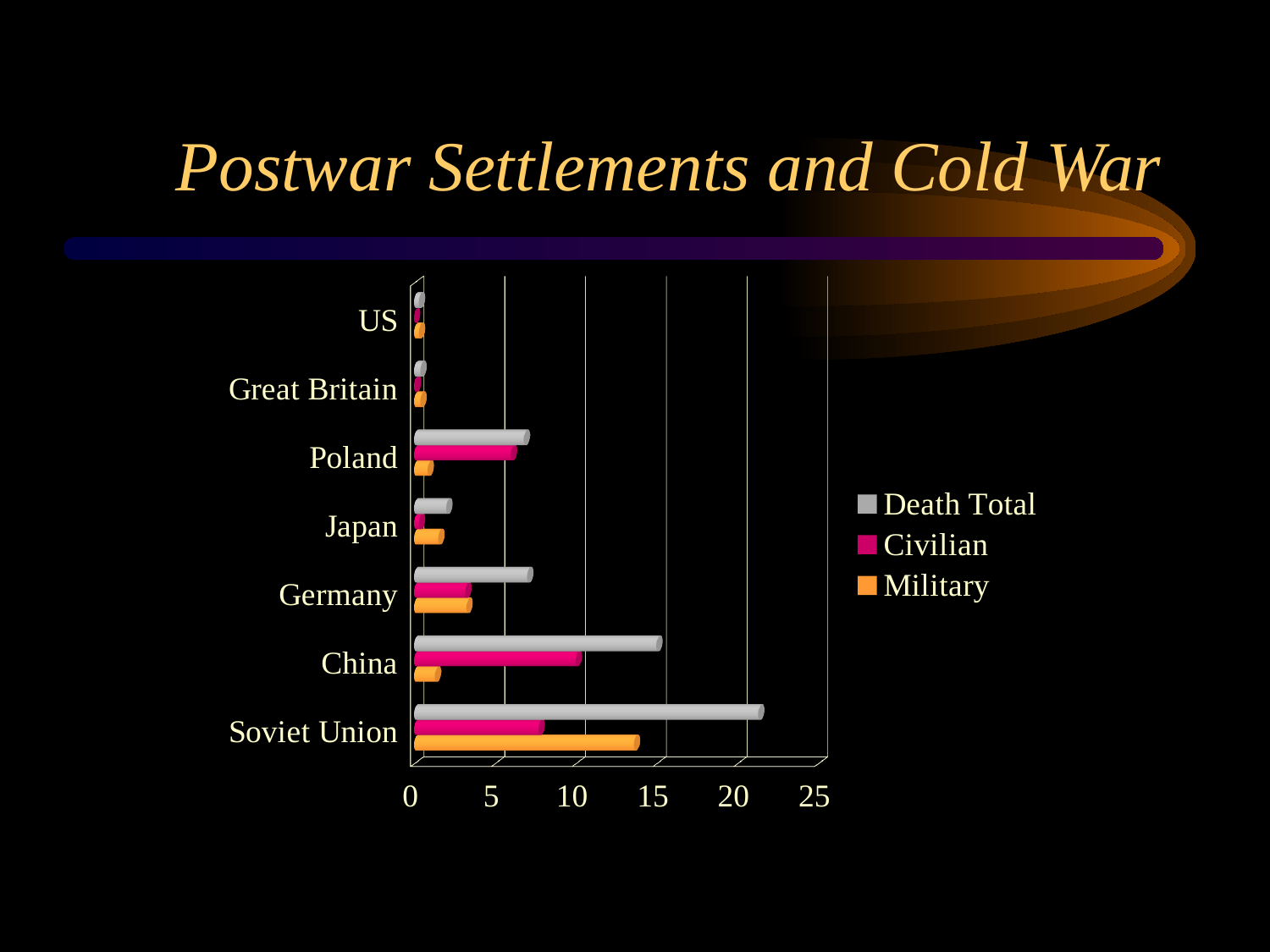
Which is larger for the Soviet Union, the Military bar or the Civilian bar? Military Which series is shown in orange in the legend? Military What kind of chart is shown on the slide? Bar chart Which country has the highest Death Total bar? Soviet Union How many series does the chart's legend list? 3 Is the Death Total value for the Soviet Union greater or less than 20? greater Is the Death Total value for Germany greater or less than 10? less Is the Military value for the Soviet Union greater or less than 10? greater Which is larger for China, the Civilian bar or the Military bar? Civilian How many countries are listed on the chart's vertical axis? 7 Which country has the highest Military bar? Soviet Union